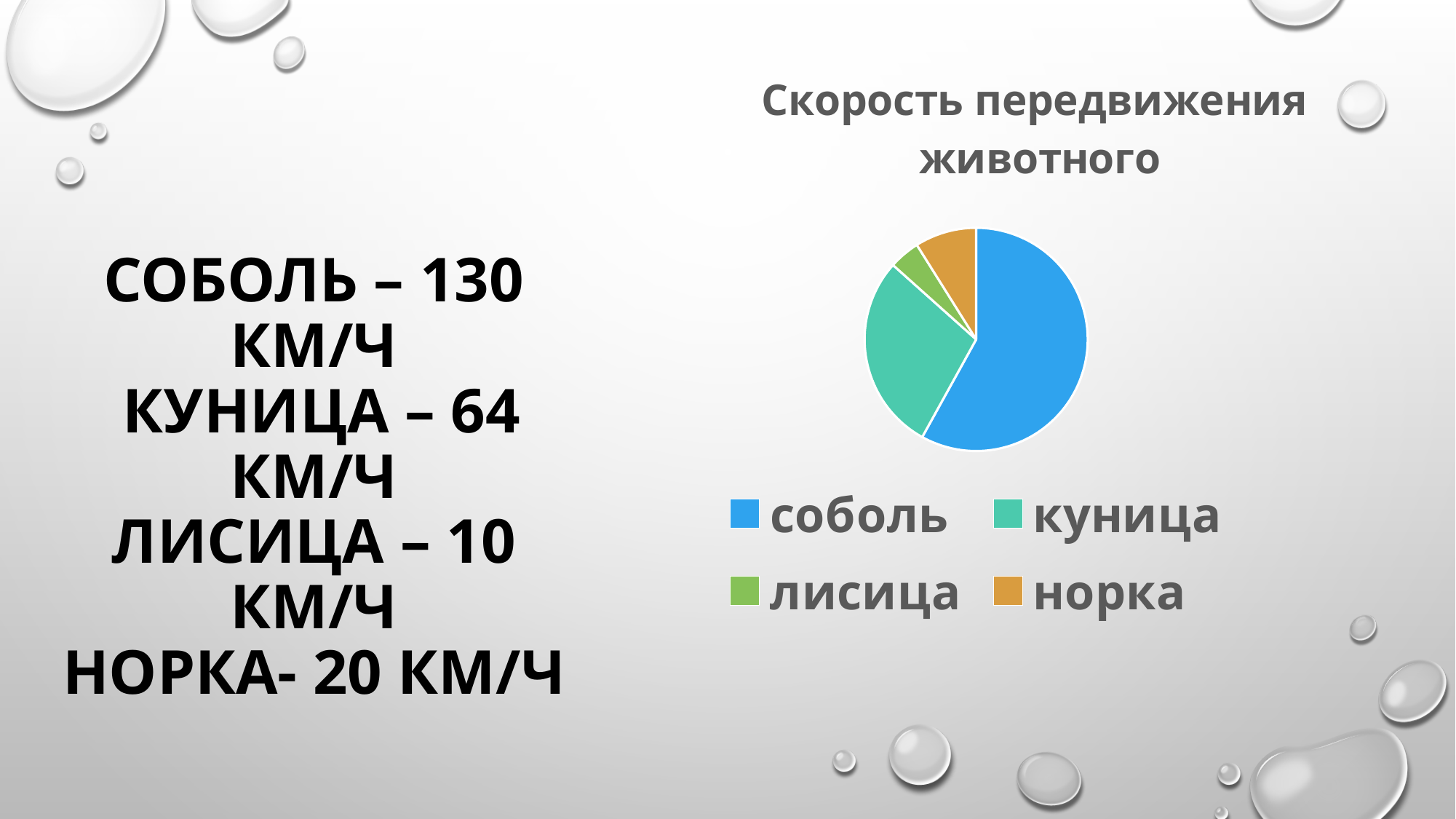
What kind of chart is shown on the slide? pie chart What colour is the slice for соболь in the pie chart? blue How many categories does the pie chart have? 4 What is the speed given for норка on the slide? 20 км/ч Which animal has the smallest slice of the pie chart? лисица What is the title of the chart? Скорость передвижения животного By how much does the speed of соболь exceed the speed of куница, according to the slide? 66 км/ч Which slice is larger, куница or норка? куница What is the speed given for соболь on the slide? 130 км/ч Which animal has the largest slice of the pie chart? соболь What is the speed given for куница on the slide? 64 км/ч By how much does the speed of норка exceed the speed of лисица, according to the slide? 10 км/ч